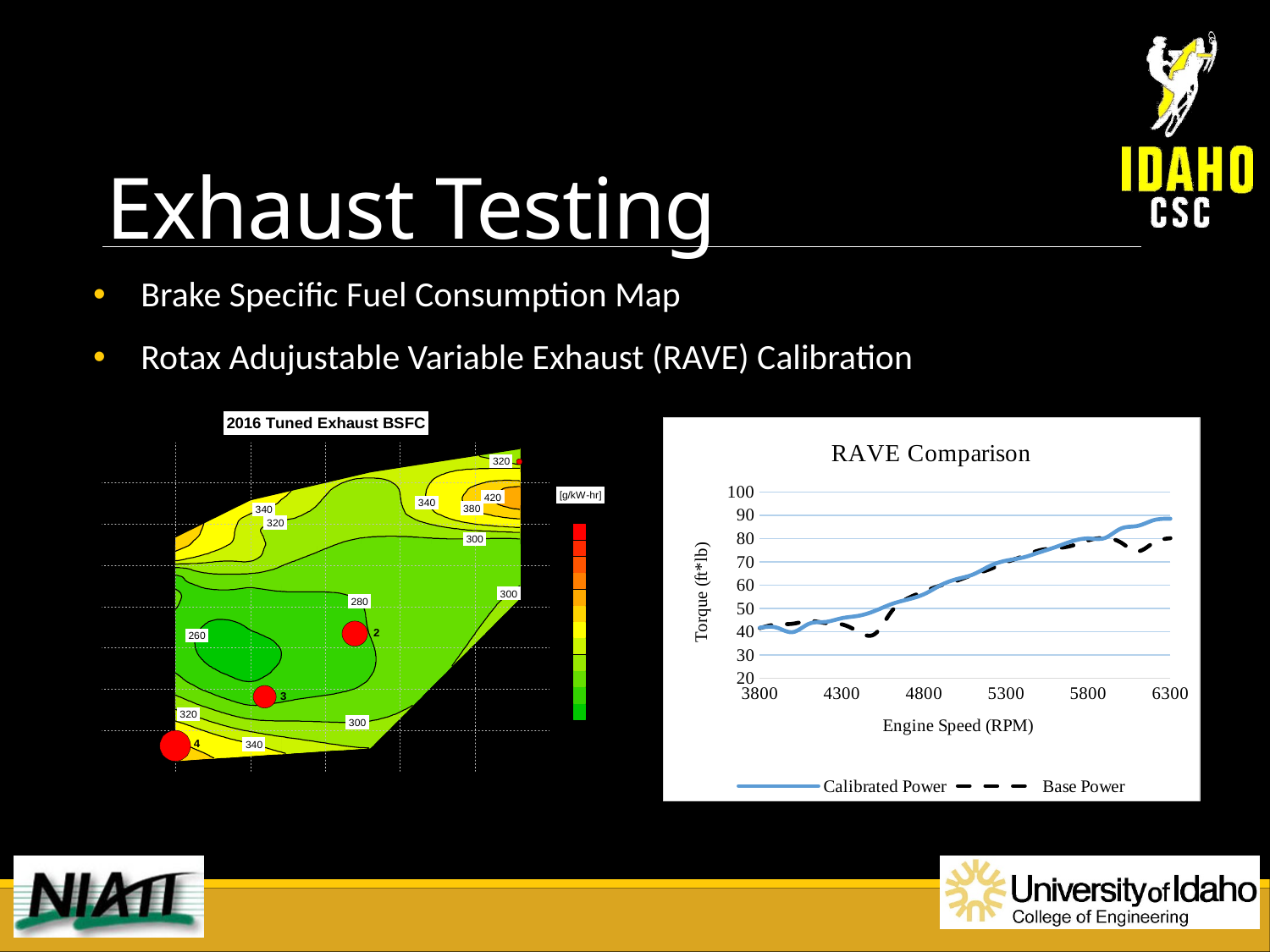
In the 2016 Tuned Exhaust BSFC map, what is the highest contour value labeled? 420 In the RAVE Comparison chart, at 6300 RPM, which series has the higher torque, Calibrated Power or Base Power? Calibrated Power What kind of chart is the RAVE Comparison chart? line chart In the RAVE Comparison chart, do the torque values generally rise or fall as engine speed increases from 3800 to 6300 RPM? rise In the RAVE Comparison chart, what is the label of the x axis? Engine Speed (RPM) In the RAVE Comparison chart, is the Base Power value at 4300 RPM greater or less than 60? less In the RAVE Comparison chart, is the Calibrated Power value at 6300 RPM greater or less than 80? greater In the RAVE Comparison chart, is the Calibrated Power value at 3800 RPM greater or less than 50? less In the RAVE Comparison chart, what are the two series named in the legend? Calibrated Power and Base Power What is the title of the chart on the left of the slide? 2016 Tuned Exhaust BSFC In the 2016 Tuned Exhaust BSFC map, what is the lowest contour value labeled? 260 How many series does the legend of the RAVE Comparison chart list? 2